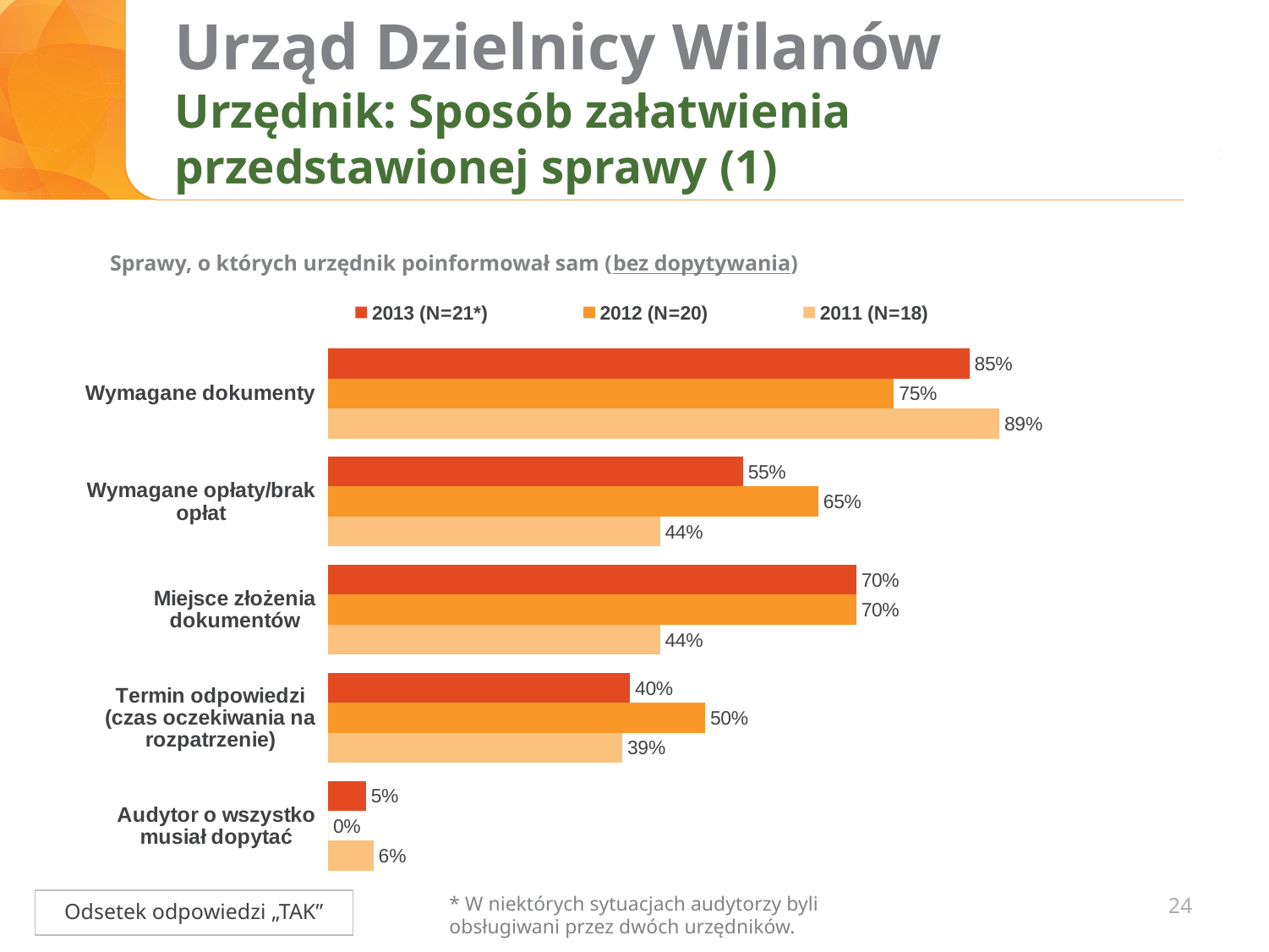
For "Wymagane opłaty/brak opłat", which series has the larger value: 2013 (N=21*) or 2012 (N=20)? 2012 (N=20) How many series does the legend list? 3 What is the value for "Termin odpowiedzi (czas oczekiwania na rozpatrzenie)" in the 2012 (N=20) series? 50% What kind of chart is shown on the slide? Bar chart Which category has the lowest value in the 2013 (N=21*) series? Audytor o wszystko musiał dopytać What is the difference between the 2013 (N=21*) and 2012 (N=20) values for "Wymagane dokumenty"? 10 percentage points What is the value for "Wymagane opłaty/brak opłat" in the 2011 (N=18) series? 44% What is the value for "Wymagane dokumenty" in the 2013 (N=21*) series? 85% How many categories are shown on the chart? 5 What is the subtitle shown above the chart? Sprawy, o których urzędnik poinformował sam (bez dopytywania) What is the value for "Audytor o wszystko musiał dopytać" in the 2012 (N=20) series? 0% Which category has the highest value in the 2011 (N=18) series? Wymagane dokumenty